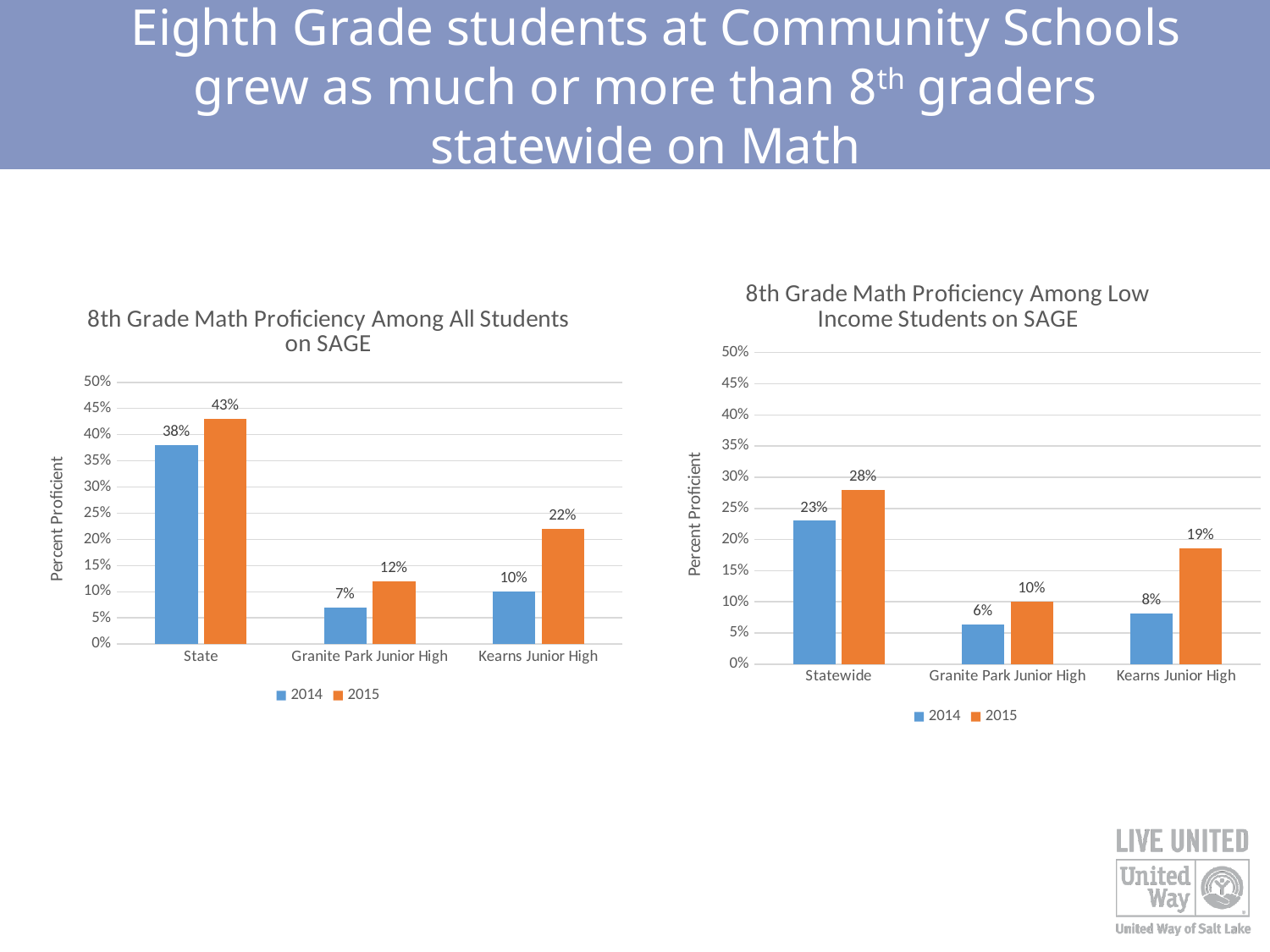
In the '8th Grade Math Proficiency Among All Students on SAGE' chart, which category has the lowest 2014 value? Granite Park Junior High In the '8th Grade Math Proficiency Among Low Income Students on SAGE' chart, what is the difference between the 2015 and 2014 values for Statewide? 5% In the '8th Grade Math Proficiency Among Low Income Students on SAGE' chart, what is the 2015 value for Kearns Junior High? 19% In the '8th Grade Math Proficiency Among Low Income Students on SAGE' chart, which is larger: the 2015 value for Granite Park Junior High or the 2014 value for Kearns Junior High? 2015 value for Granite Park Junior High How many series does the legend of the '8th Grade Math Proficiency Among Low Income Students on SAGE' chart list? 2 In the '8th Grade Math Proficiency Among Low Income Students on SAGE' chart, which category has the highest 2015 value? Statewide In the '8th Grade Math Proficiency Among Low Income Students on SAGE' chart, what is the 2014 value for Statewide? 23% In the '8th Grade Math Proficiency Among All Students on SAGE' chart, what is the difference between the 2015 and 2014 values for Kearns Junior High? 12% What type of chart is the '8th Grade Math Proficiency Among All Students on SAGE' chart? Bar chart How many categories are shown on the x axis of the '8th Grade Math Proficiency Among All Students on SAGE' chart? 3 In the '8th Grade Math Proficiency Among All Students on SAGE' chart, what is the 2015 value for State? 43% In the '8th Grade Math Proficiency Among All Students on SAGE' chart, what is the 2014 value for Granite Park Junior High? 7%